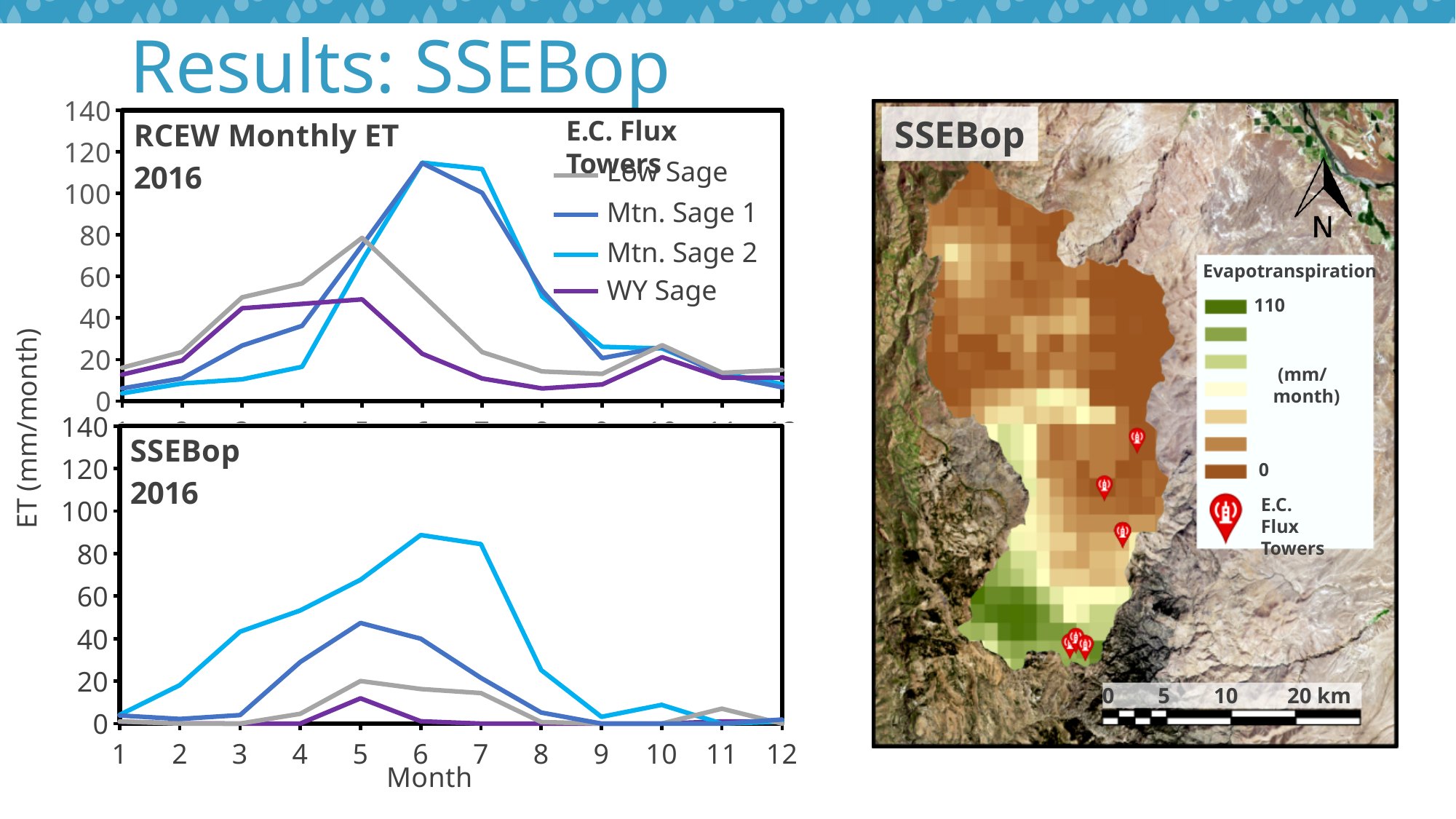
In the top chart 'RCEW Monthly ET 2016', which is larger in month 5: Low Sage or WY Sage? Low Sage In the bottom chart 'SSEBop 2016', which series has the lowest peak value? WY Sage In the top chart 'RCEW Monthly ET 2016', is the value for WY Sage in month 8 greater or less than 20? less What kind of chart is the top chart titled 'RCEW Monthly ET 2016'? line chart In the bottom chart 'SSEBop 2016', which series reaches the highest value? Mtn. Sage 2 In the bottom chart 'SSEBop 2016', do the values for Mtn. Sage 2 rise or fall from month 7 to month 9? fall In the top chart 'RCEW Monthly ET 2016', is the value for Low Sage in month 5 greater or less than 60? greater In the top chart 'RCEW Monthly ET 2016', in which month does Low Sage reach its highest value? 5 How many series does the legend of the top chart 'RCEW Monthly ET 2016' list? 4 In the bottom chart 'SSEBop 2016', is the value for Mtn. Sage 2 in month 6 greater or less than 80? greater How many months are shown along the x axis of the bottom chart 'SSEBop 2016'? 12 What is the label on the shared y axis of the two line charts? ET (mm/month)